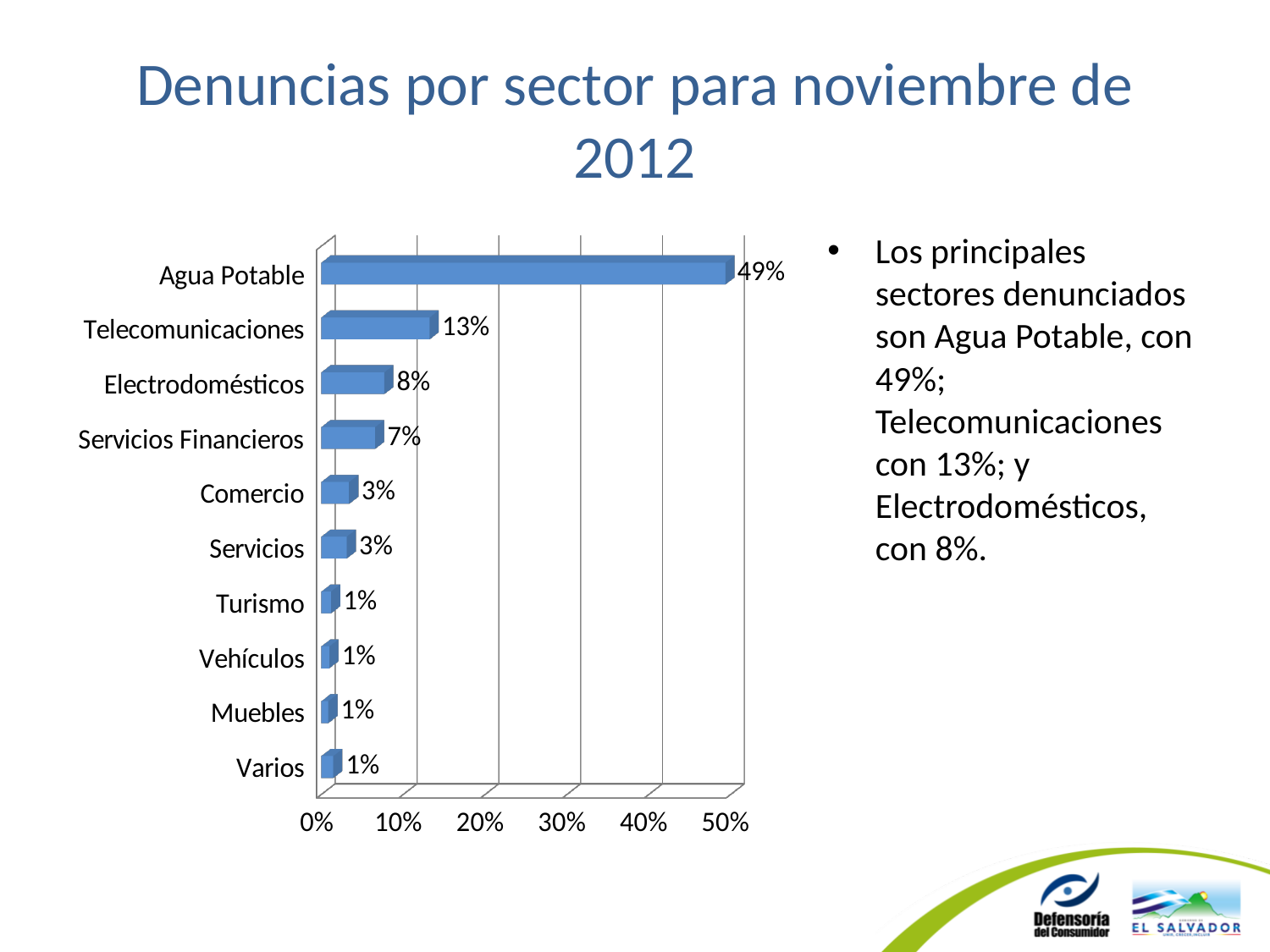
What is the difference between the values for Electrodomésticos and Servicios Financieros? 1% What is the value for Electrodomésticos? 8% What is the value for Agua Potable? 49% What is the title of the slide? Denuncias por sector para noviembre de 2012 What is the value for Telecomunicaciones? 13% How many sectors are shown in the chart? 10 What kind of chart is shown on the slide? Bar chart What is the difference between the values for Agua Potable and Telecomunicaciones? 36% Which sector has the highest value? Agua Potable Which is larger, the value for Telecomunicaciones or the value for Electrodomésticos? Telecomunicaciones What is the value for Servicios Financieros? 7% Is the value for Agua Potable greater or less than 40%? greater